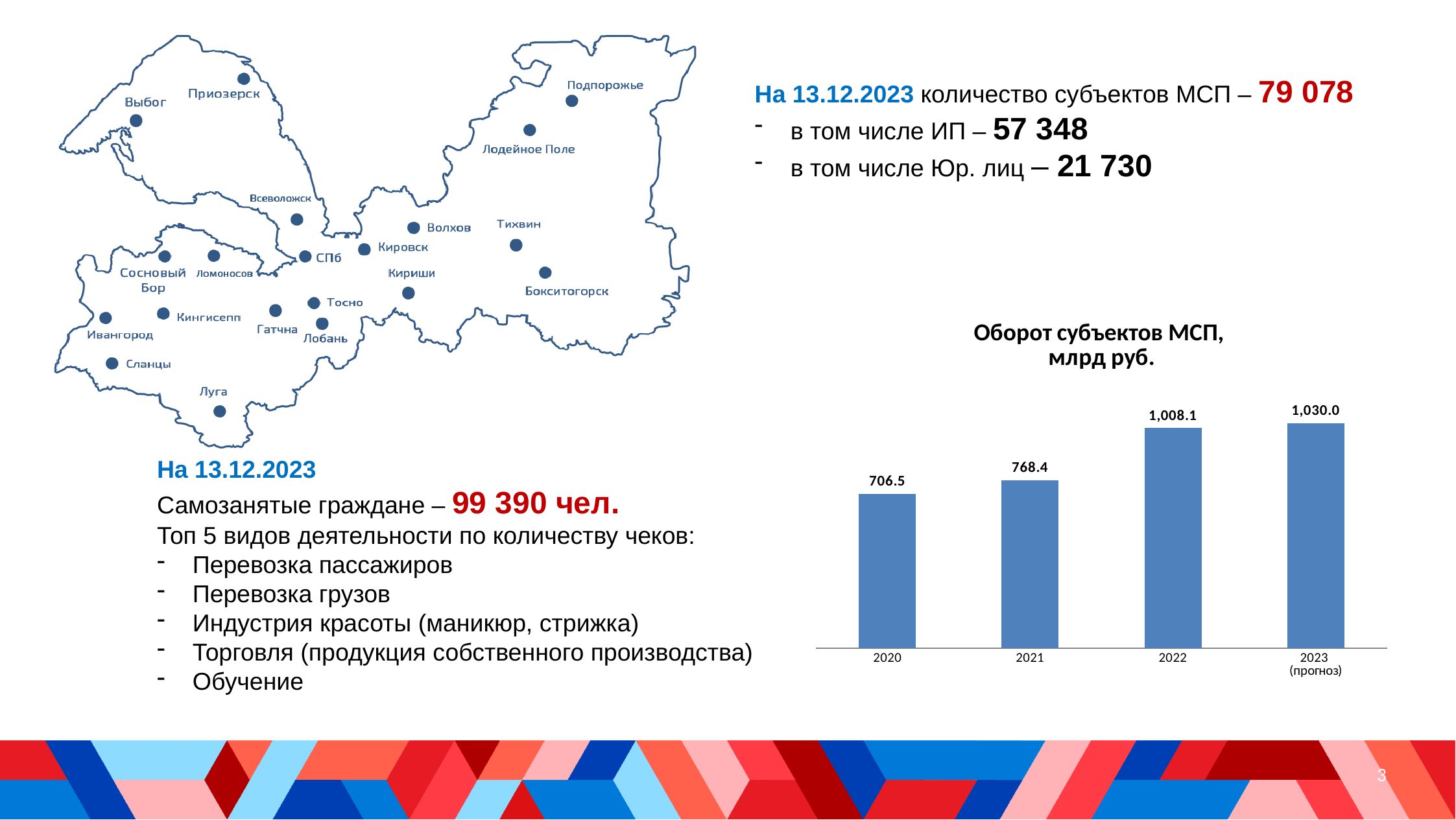
What is the value for 2022 in the chart? 1,008.1 Which is larger, the value for 2021 or the value for 2020? 2021 What is the value for 2020 in the chart? 706.5 What is the title of the chart on the slide? Оборот субъектов МСП, млрд руб. How many bars (years) are shown in the chart? 4 What is the difference between the values for 2022 and 2021? 239.7 Do the values rise or fall from 2020 to 2023 (прогноз)? rise Which year has the lowest value in the chart? 2020 Which year has the highest value in the chart? 2023 (прогноз) What is the value for 2021 in the chart? 768.4 What is the value for 2023 (прогноз) in the chart? 1,030.0 What type of chart is shown on the slide? bar chart